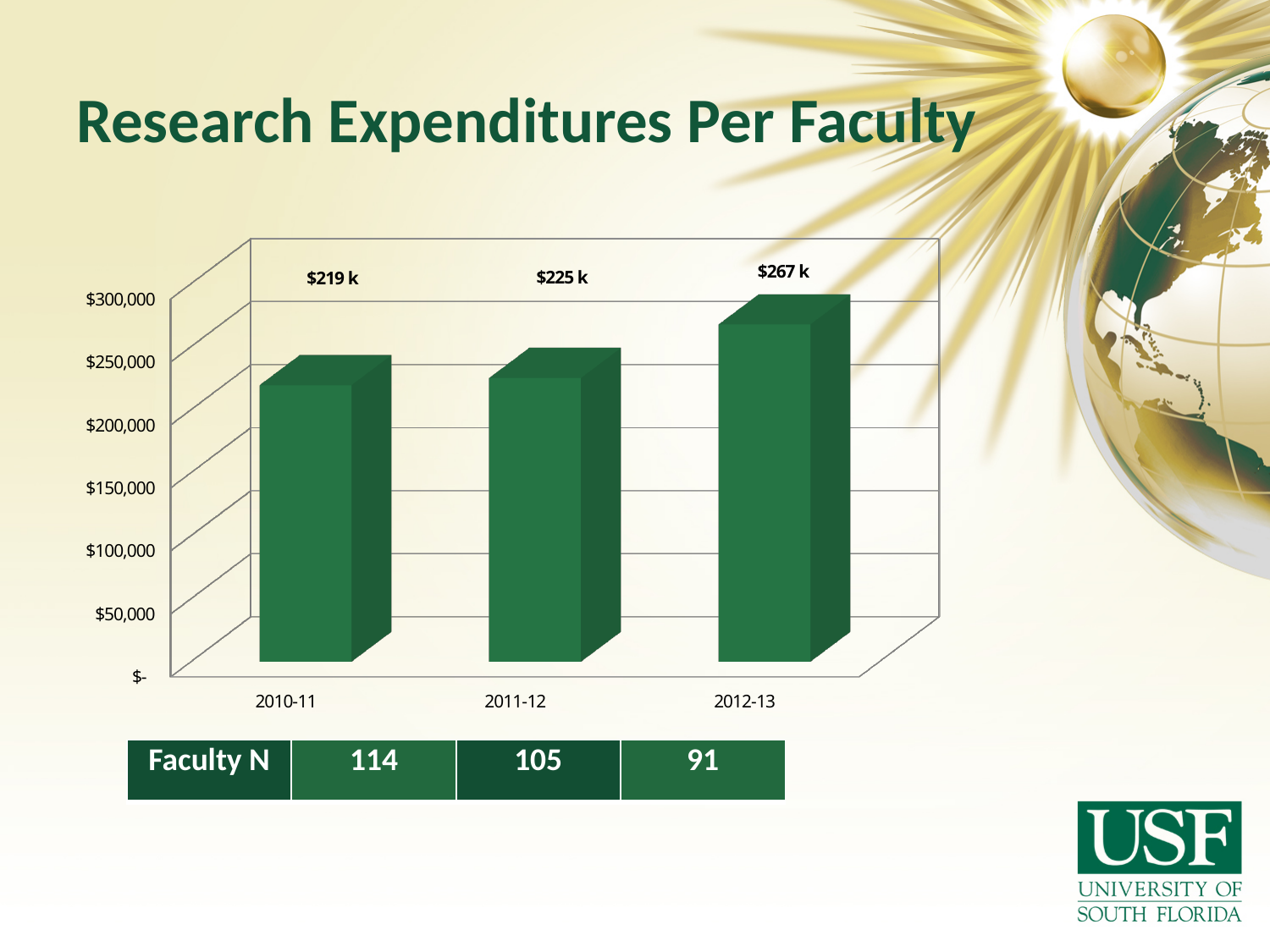
What is the research expenditure per faculty for 2011-12? $225 k Which year has the lowest research expenditure per faculty? 2010-11 What is the difference between the 2012-13 and 2010-11 research expenditures per faculty? $48 k What kind of chart is shown on the slide? bar chart Which is larger, the research expenditure per faculty in 2011-12 or in 2012-13? 2012-13 What is the research expenditure per faculty for 2012-13? $267 k How many years are shown on the x axis of the chart? 3 Do the research expenditures per faculty rise or fall from 2010-11 to 2012-13? rise Is the value for 2012-13 greater or less than $250,000? greater What is the research expenditure per faculty for 2010-11? $219 k What is the title of the chart on the slide? Research Expenditures Per Faculty Which year has the highest research expenditure per faculty? 2012-13